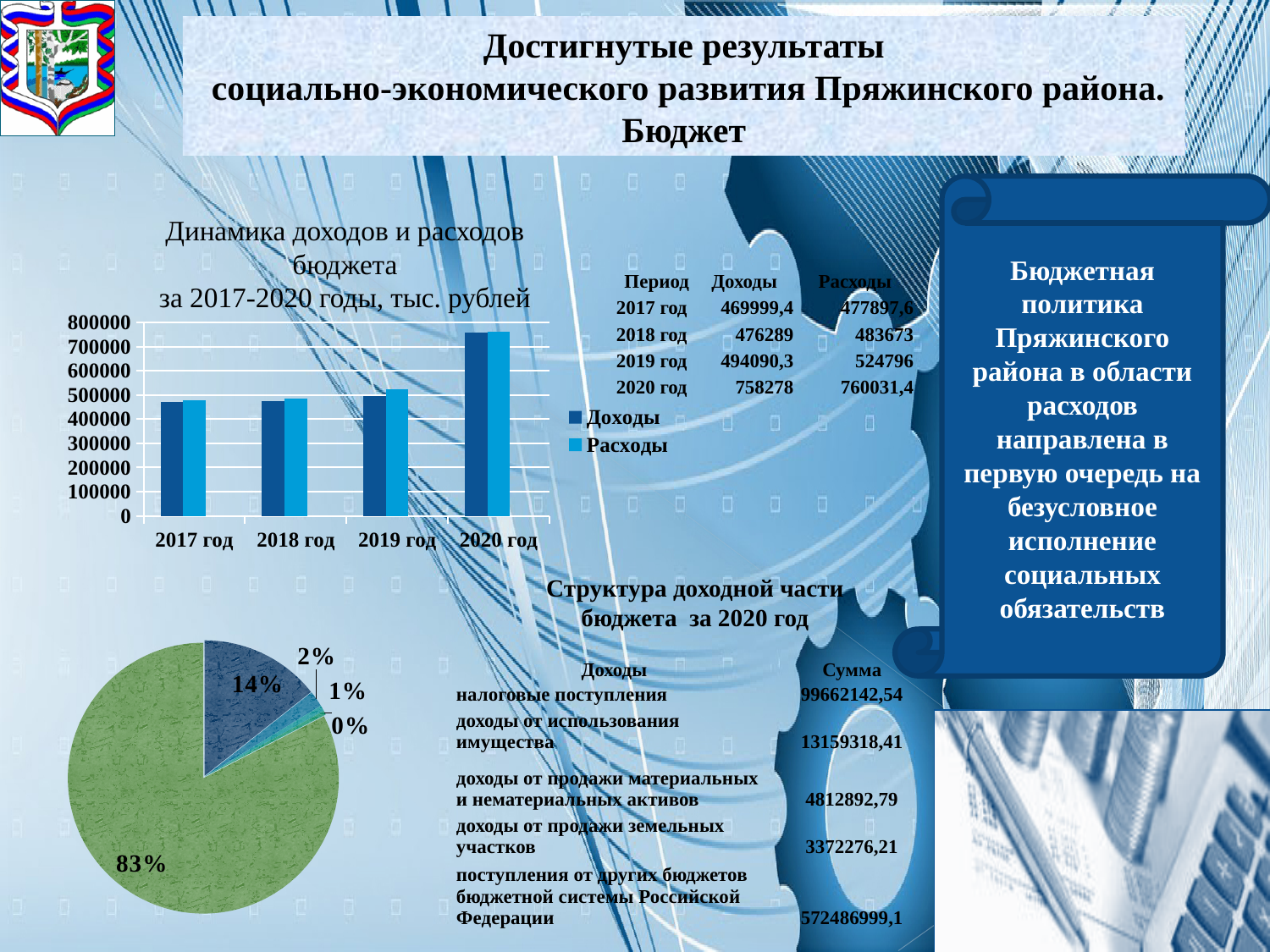
In the 'Динамика доходов и расходов бюджета' chart, what is the difference between Расходы and Доходы for 2019 год? 30705,7 What kind of chart is the 'Структура доходной части бюджета за 2020 год' chart? pie chart In the 'Динамика доходов и расходов бюджета' chart, how many years are shown on the x axis? 4 In the 'Структура доходной части бюджета за 2020 год' pie chart, what share does the largest slice have? 83% In the 'Динамика доходов и расходов бюджета' chart, what is the value of Расходы for 2019 год? 524796 In the 'Динамика доходов и расходов бюджета' chart, what is the value of Доходы for 2017 год? 469999,4 What kind of chart is the 'Динамика доходов и расходов бюджета' chart? bar chart In the 'Динамика доходов и расходов бюджета' chart, how many series does the legend list? 2 In the 'Динамика доходов и расходов бюджета' chart, do the Доходы values rise or fall from 2017 год to 2020 год? rise In the 'Динамика доходов и расходов бюджета' chart, which year has the highest Доходы? 2020 год In the 'Динамика доходов и расходов бюджета' chart, which year has the lowest Расходы? 2017 год In the 'Динамика доходов и расходов бюджета' chart, which is larger for 2020 год, Доходы or Расходы? Расходы